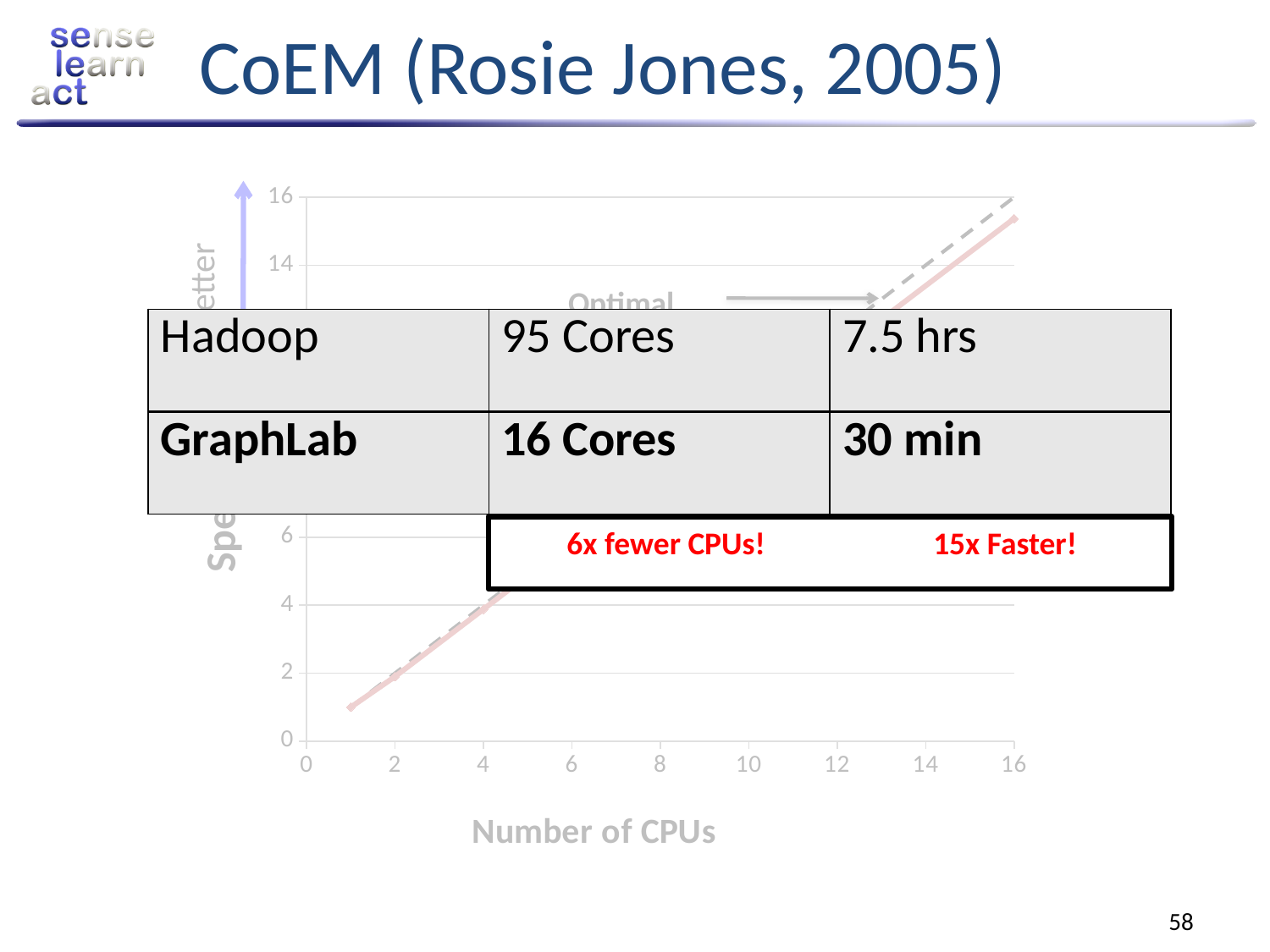
What kind of chart is shown on the slide? line chart Do the plotted values rise or fall as the number of CPUs increases? rise Is the value of the solid line at 4 CPUs greater or less than 6? less What is the highest value shown on the x axis of the chart? 16 What is the name of the dashed reference line on the chart? Optimal Is the value of the solid line at 16 CPUs greater or less than 14? greater Is the value of the solid line at 16 CPUs greater or less than 6? greater What is the label of the x axis of the chart? Number of CPUs